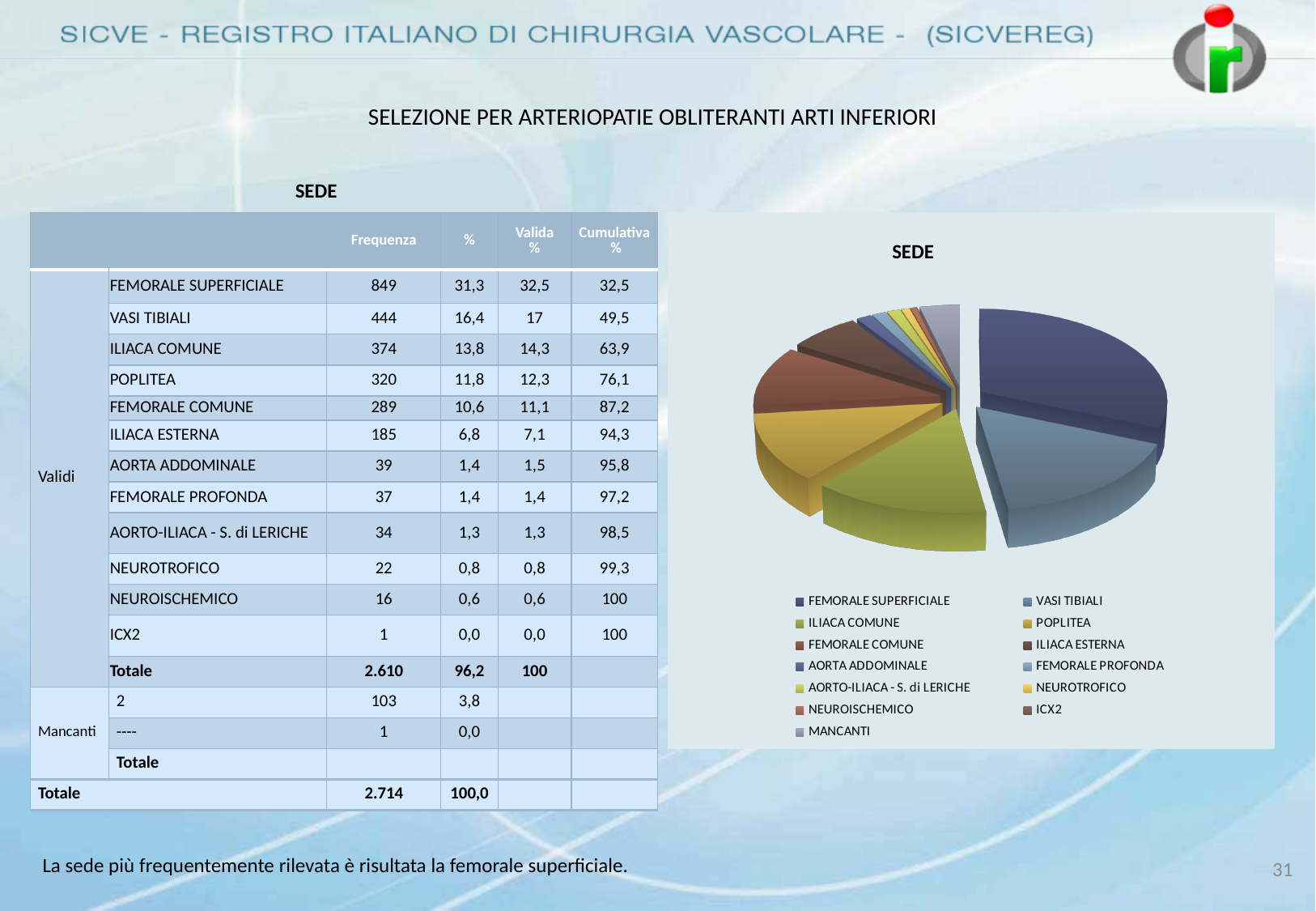
Which slice is larger in the pie chart, FEMORALE SUPERFICIALE or VASI TIBIALI? FEMORALE SUPERFICIALE According to the table on the slide, what is the valid percentage (Valida %) for ILIACA COMUNE? 14,3 What kind of chart is shown on the slide? pie chart According to the table on the slide, what is the difference in frequency between FEMORALE SUPERFICIALE and VASI TIBIALI? 405 What is the title of the pie chart? SEDE According to the table on the slide, what is the frequency for VASI TIBIALI? 444 Which slice is larger in the pie chart, ILIACA COMUNE or AORTA ADDOMINALE? ILIACA COMUNE According to the table on the slide, what is the frequency for FEMORALE SUPERFICIALE? 849 Which legend entry of the pie chart is listed last? MANCANTI How many entries does the legend of the pie chart list? 13 Which category has the largest slice in the pie chart? FEMORALE SUPERFICIALE Which slice is larger in the pie chart, POPLITEA or NEUROTROFICO? POPLITEA